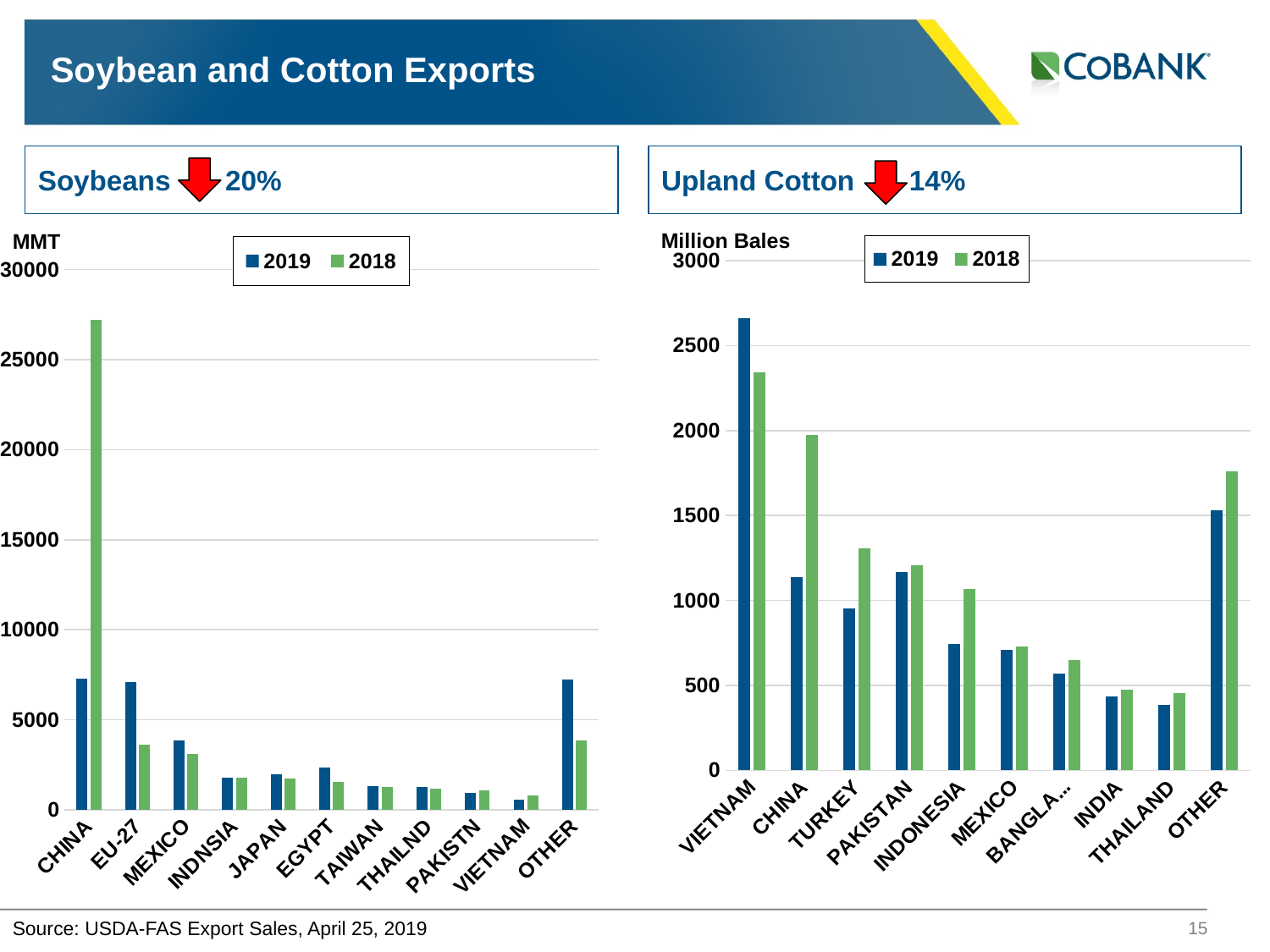
How many series does the legend of the Upland Cotton chart list? 2 On the Upland Cotton chart, is the 2019 value for VIETNAM greater or less than 2500? greater On the Soybeans chart, which category has the lowest 2019 value? VIETNAM On the Soybeans chart, is the 2019 value for CHINA greater or less than 5000? greater On the Upland Cotton chart, which is larger for TURKEY, the 2019 value or the 2018 value? 2018 On the Soybeans chart, which category has the highest 2018 value? CHINA On the Upland Cotton chart, which category has the highest 2019 value? VIETNAM What unit is shown on the y axis of the Upland Cotton chart? Million Bales How many categories are shown on the Soybeans chart? 11 On the Soybeans chart, which is larger for CHINA, the 2019 value or the 2018 value? 2018 On the Soybeans chart, is the 2018 value for CHINA greater or less than 25000? greater